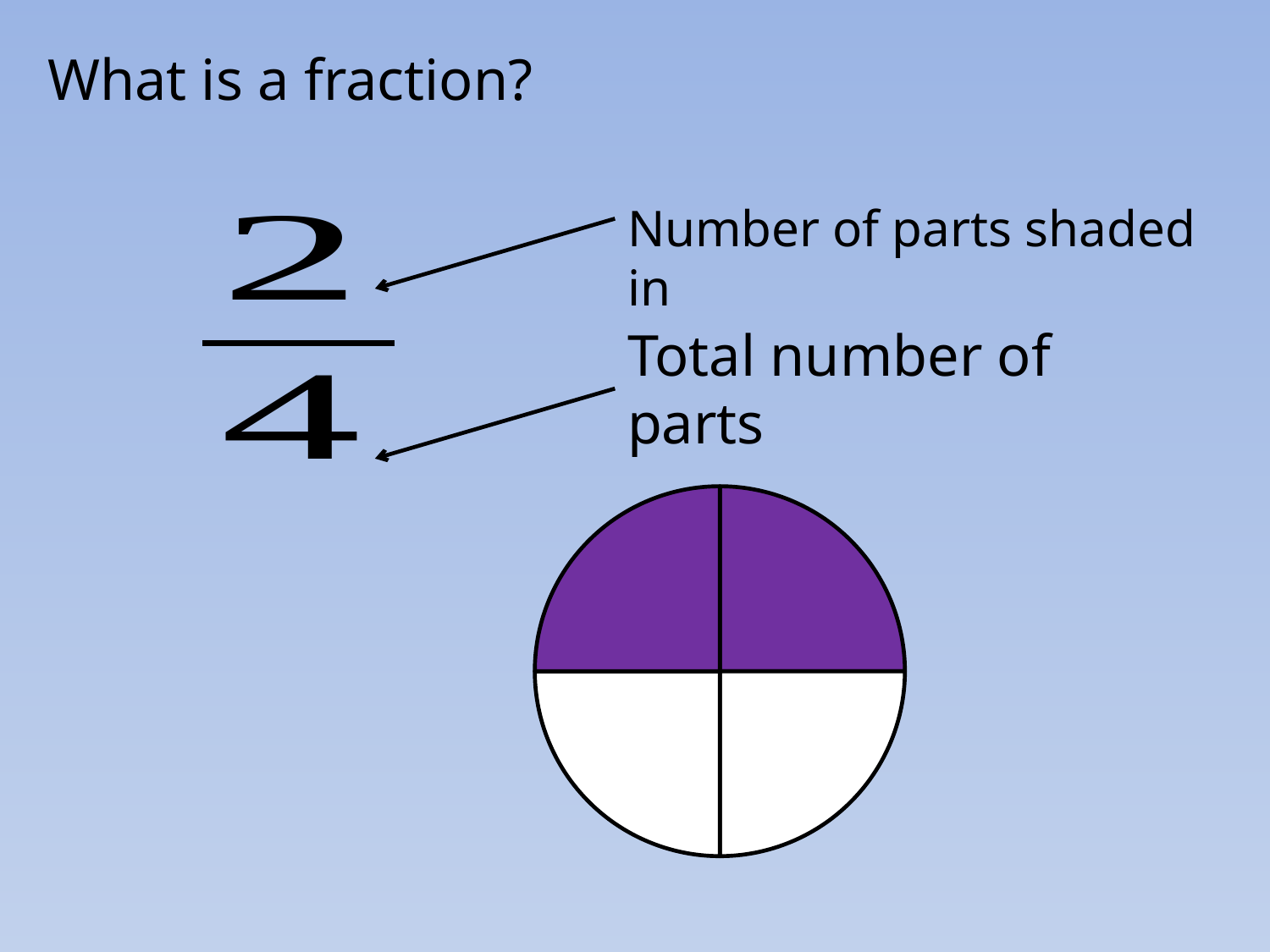
How many parts of the circle are shaded in? 2 How many equal parts is the circle divided into? 4 According to the slide, what does the top number of the fraction (2) represent? Number of parts shaded in What fraction does the slide say the shaded circle represents? 2/4 What is the title of the slide? What is a fraction? Are more parts of the circle shaded or unshaded? Equal (2 shaded, 2 unshaded) What colour are the shaded parts of the circle? Purple